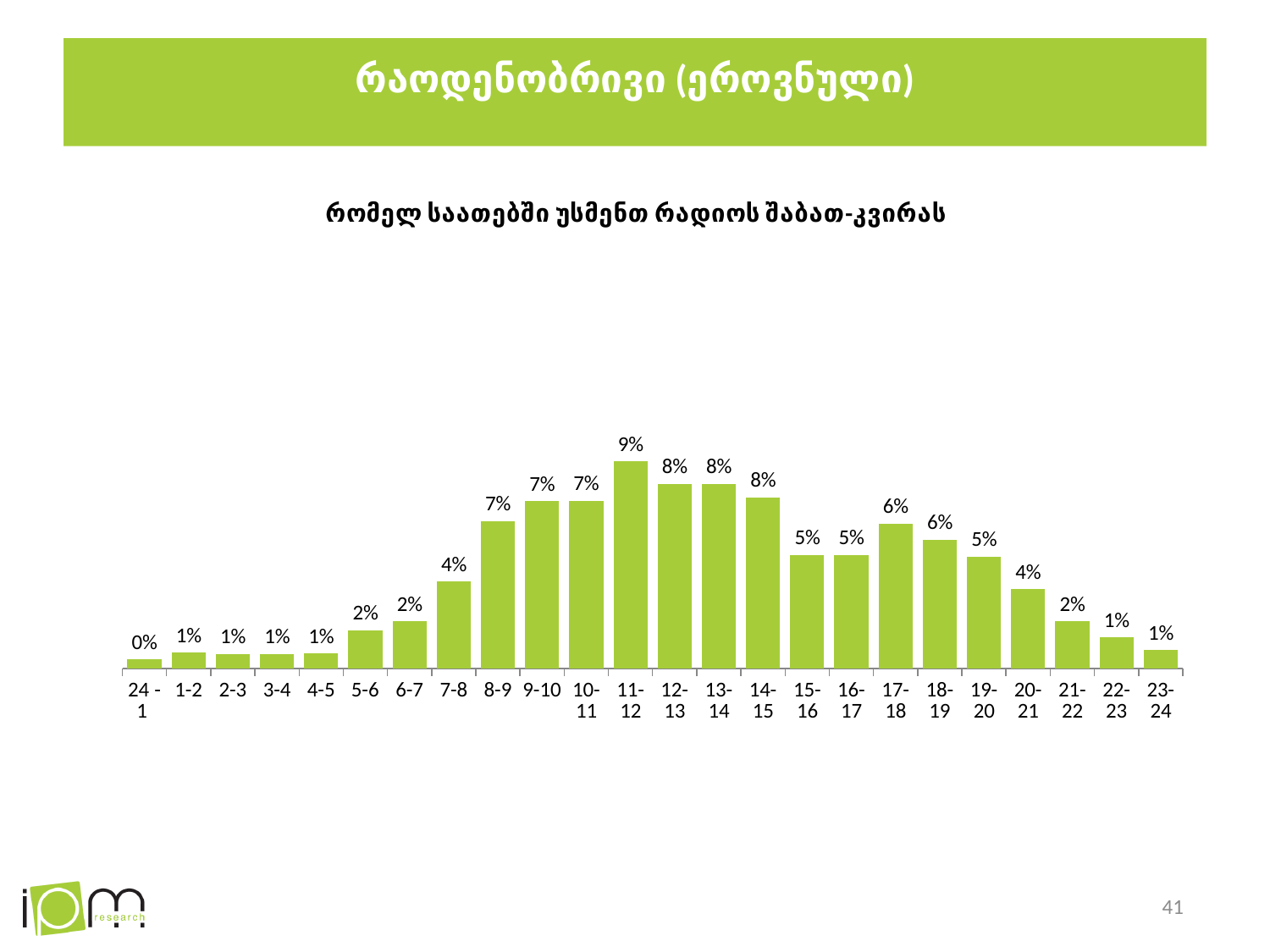
What is the value for the 7-8 time slot? 4% What kind of chart is shown on the slide? Bar chart Do the values rise or fall from the 14-15 slot to the 16-17 slot? Fall What percentage is shown for the 11-12 time slot? 9% What is the difference between the values for 11-12 and 15-16? 4% How many time slots are shown on the x axis? 24 Which time slot has the highest percentage? 11-12 What is the value for the 20-21 time slot? 4% Which is larger, the value for 8-9 or the value for 19-20? 8-9 What colour are the bars in the chart? Green Which time slot has the lowest percentage? 24 - 1 What percentage is shown for the 17-18 time slot? 6%